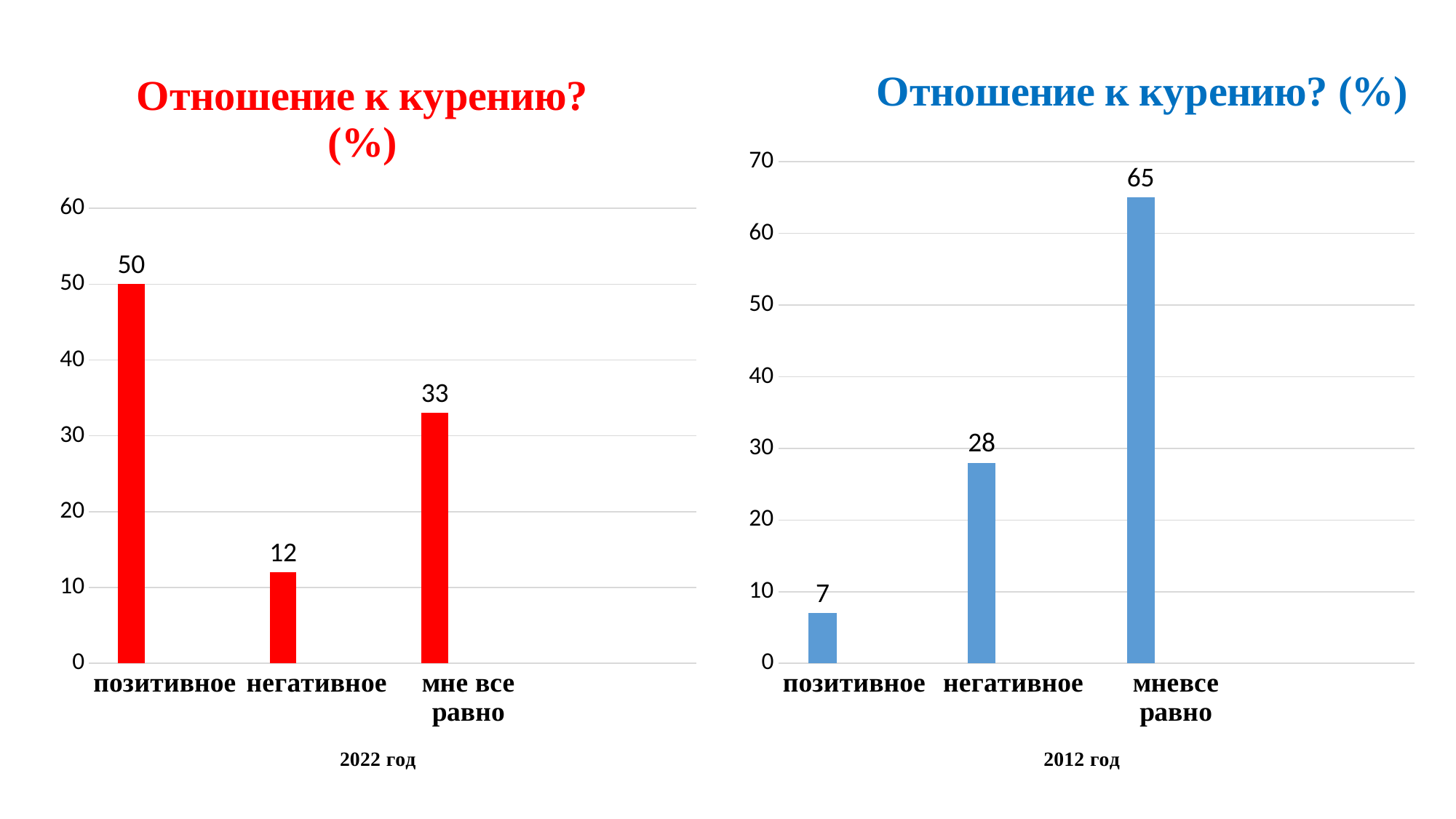
In the right chart (2012 год), what is the difference between the values for мне все равно and негативное? 37 In the right chart (2012 год), what is the value for позитивное? 7 In the left chart (2022 год), which category has the highest value? позитивное In the right chart (2012 год), what is the value for мне все равно? 65 In the left chart (2022 год), what is the value for позитивное? 50 In the left chart (2022 год), what is the difference between the values for позитивное and мне все равно? 17 How many categories are shown in the left chart (2022 год)? 3 What colour are the bars in the left chart (2022 год)? red What kind of chart is the right chart (2012 год)? bar chart In the left chart (2022 год), what is the value for негативное? 12 In the right chart (2012 год), which is larger: негативное or позитивное? негативное In the right chart (2012 год), which category has the lowest value? позитивное